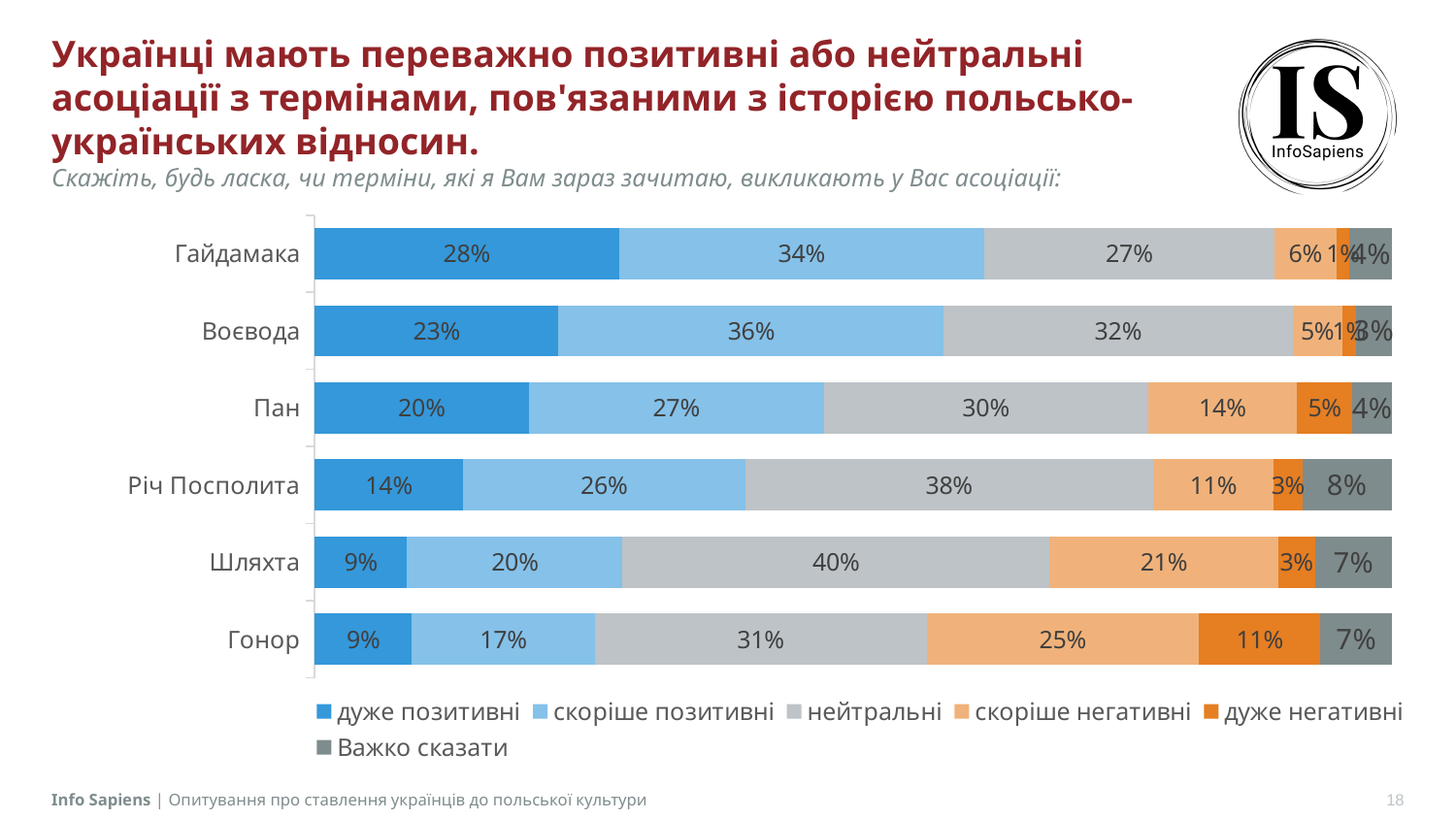
Which term has the highest share of 'дуже позитивні' associations? Гайдамака What is the difference between the 'нейтральні' values for 'Річ Посполита' and 'Пан'? 8% Which term has the lowest share of 'скоріше позитивні' associations? Гонор How many terms (categories) are shown in the chart? 6 Which term has the highest share of 'дуже негативні' associations? Гонор What percentage of respondents have 'дуже позитивні' associations with the term 'Гайдамака'? 28% What is the 'скоріше негативні' value for 'Гонор'? 25% Which is larger: the 'скоріше негативні' value for 'Шляхта' or for 'Пан'? Шляхта Which legend entry is shown in dark grey? Важко сказати How many series does the legend list? 6 What is the 'нейтральні' value for 'Шляхта'? 40% What type of chart is shown on the slide? stacked bar chart